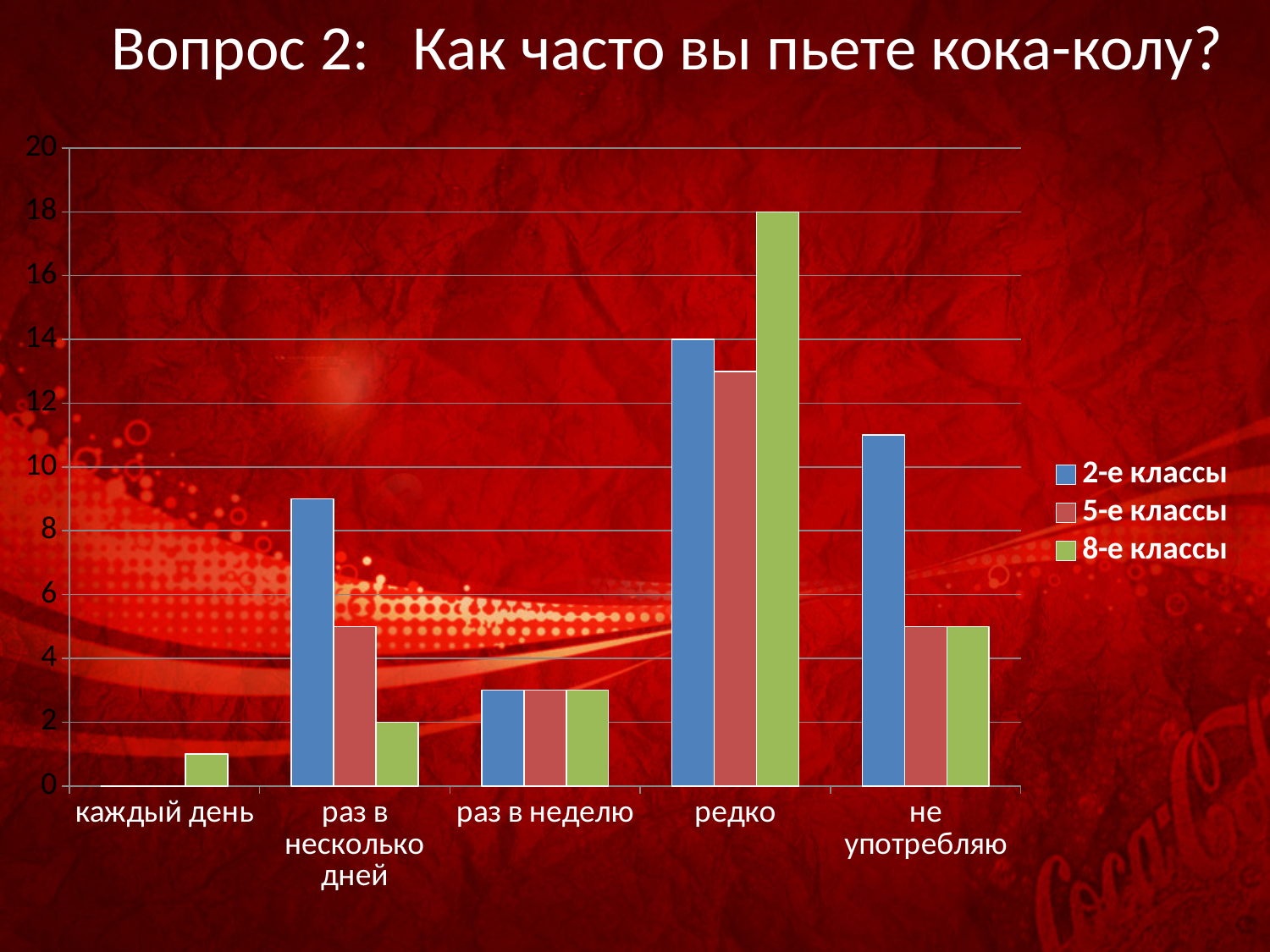
What is the value for 8-е классы in the category раз в несколько дней? 2 Which category has the highest bar for 8-е классы? редко Is the value for 5-е классы in the category раз в неделю greater or less than 4? less What is the difference between the 8-е классы and 2-е классы values in the category редко? 4 How many categories are shown on the x axis? 5 What is the value for 2-е классы in the category редко? 14 Which category has the lowest bar for 2-е классы? каждый день What is the value for 8-е классы in the category редко? 18 In the category раз в несколько дней, which is larger: the value for 2-е классы or for 5-е классы? 2-е классы Is the value for 2-е классы in the category не употребляю greater or less than 10? greater What kind of chart is shown on the slide? bar chart How many series does the legend list? 3